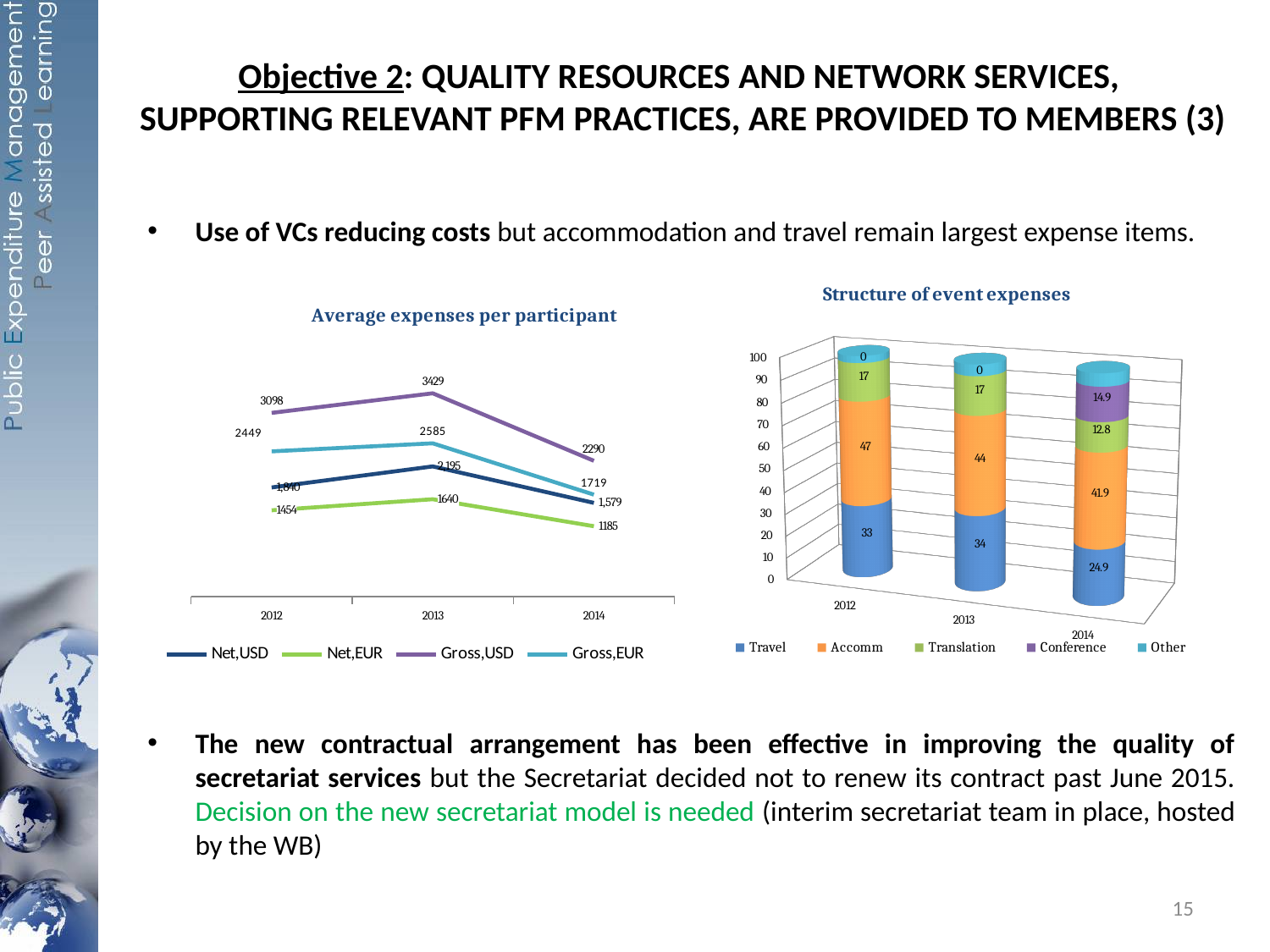
In the 'Average expenses per participant' chart, in which year is Gross,USD highest? 2013 In the 'Average expenses per participant' chart, does Gross,EUR rise or fall from 2013 to 2014? fall In the 'Average expenses per participant' chart, what is the Net,EUR value for 2014? 1185 In the 'Structure of event expenses' chart, is the Accomm value larger in 2012 or 2013? 2012 How many series does the legend of the 'Structure of event expenses' chart list? 5 What kind of chart is the 'Structure of event expenses' chart? stacked bar chart How many series does the legend of the 'Average expenses per participant' chart list? 4 In the 'Average expenses per participant' chart, what is the Gross,USD value for 2013? 3429 What kind of chart is the 'Average expenses per participant' chart? line chart In the 'Average expenses per participant' chart, what is the difference between the Gross,USD values for 2013 and 2014? 1139 In the 'Structure of event expenses' chart, what is the Travel value for 2012? 33 In the 'Structure of event expenses' chart, what is the Accomm value for 2014? 41.9